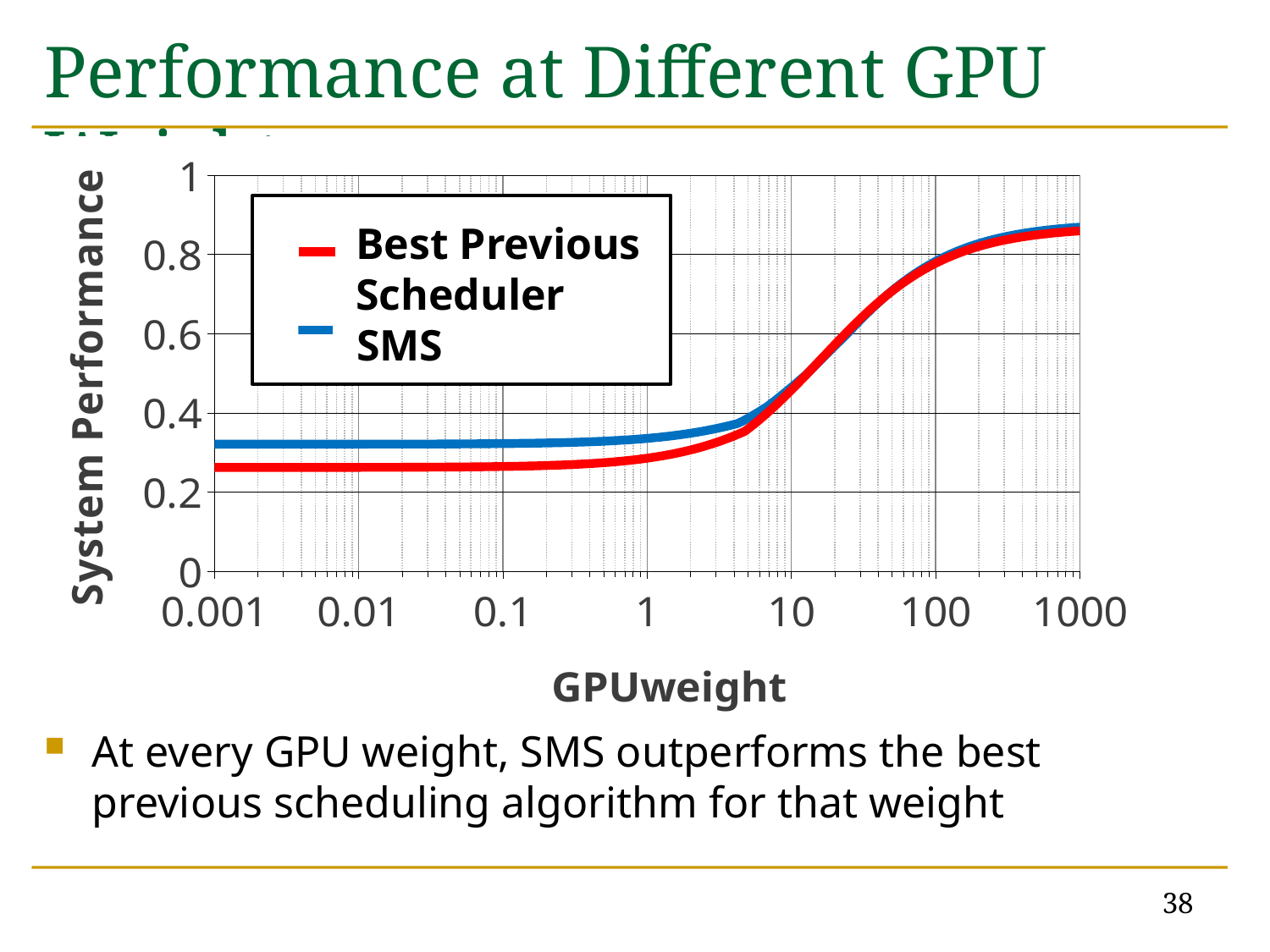
Is the System Performance of the Best Previous Scheduler at a GPUweight of 1 greater or less than 0.4? less Is the System Performance of the Best Previous Scheduler at a GPUweight of 0.001 greater or less than 0.4? less How many series does the legend list? 2 At a GPUweight of 1, which series has the higher System Performance, SMS or Best Previous Scheduler? SMS Is the System Performance of SMS at a GPUweight of 10 greater or less than 0.4? greater Which two series are listed in the chart legend? Best Previous Scheduler and SMS At a GPUweight of 0.001, which series has the higher System Performance, SMS or Best Previous Scheduler? SMS What kind of chart is shown on the slide? line chart What is the label of the x axis? GPUweight Do the System Performance values rise or fall as GPUweight increases from 0.001 to 1000? rise